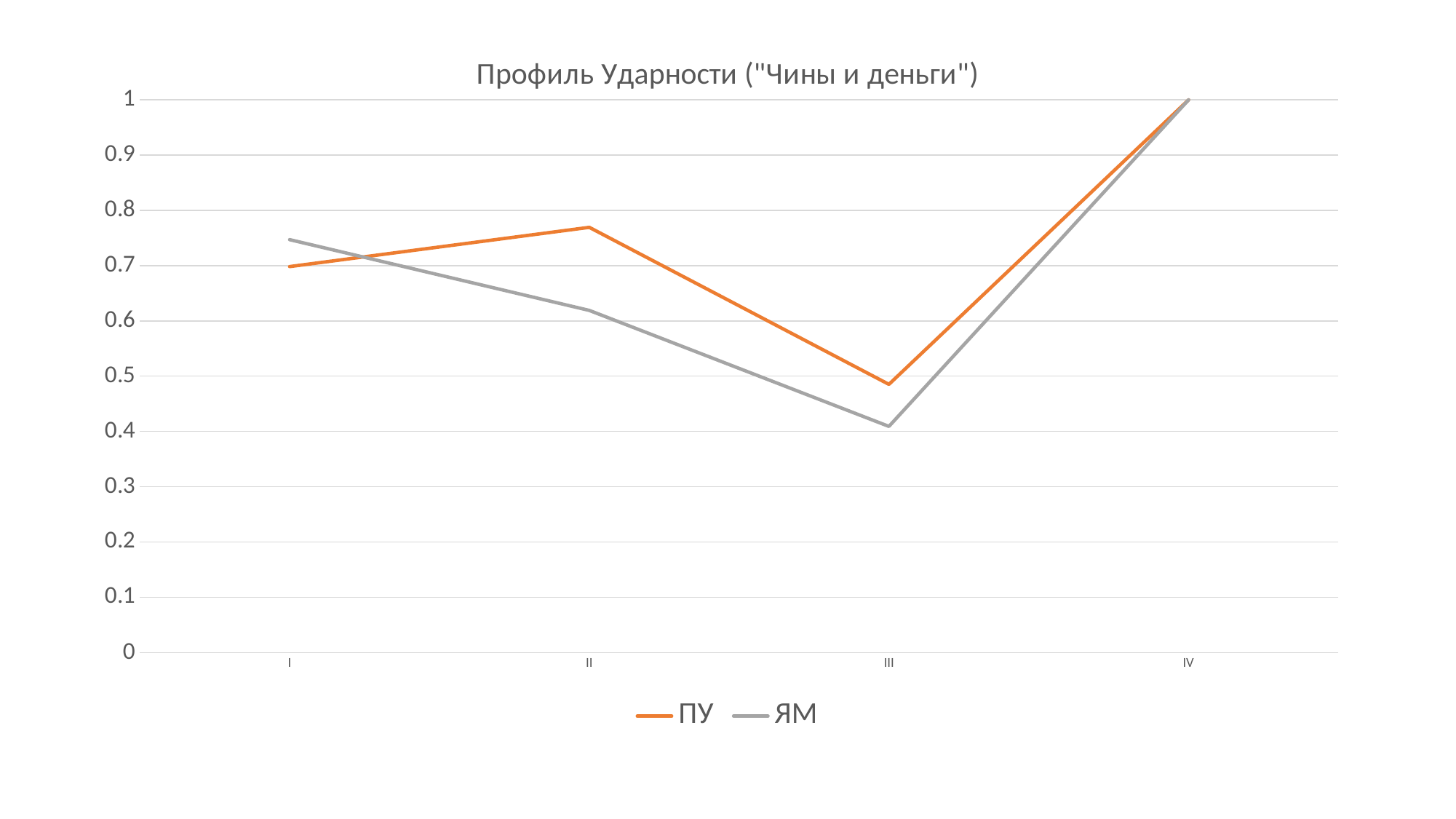
At which category does the ЯМ series reach its lowest value? III Does the ЯМ series rise or fall from category I to category III? fall What is the value of ЯМ at category IV? 1 How many categories are shown on the x axis? 4 What is the title of the chart? Профиль Ударности ("Чины и деньги") How many series does the legend list? 2 Is the value for ПУ at category II greater or less than 0.7? greater What is the value of ПУ at category IV? 1 At which category does the ПУ series reach its lowest value? III What kind of chart is shown on the slide? line chart Is the value for ЯМ at category III greater or less than 0.5? less At category II, which series has the larger value, ПУ or ЯМ? ПУ